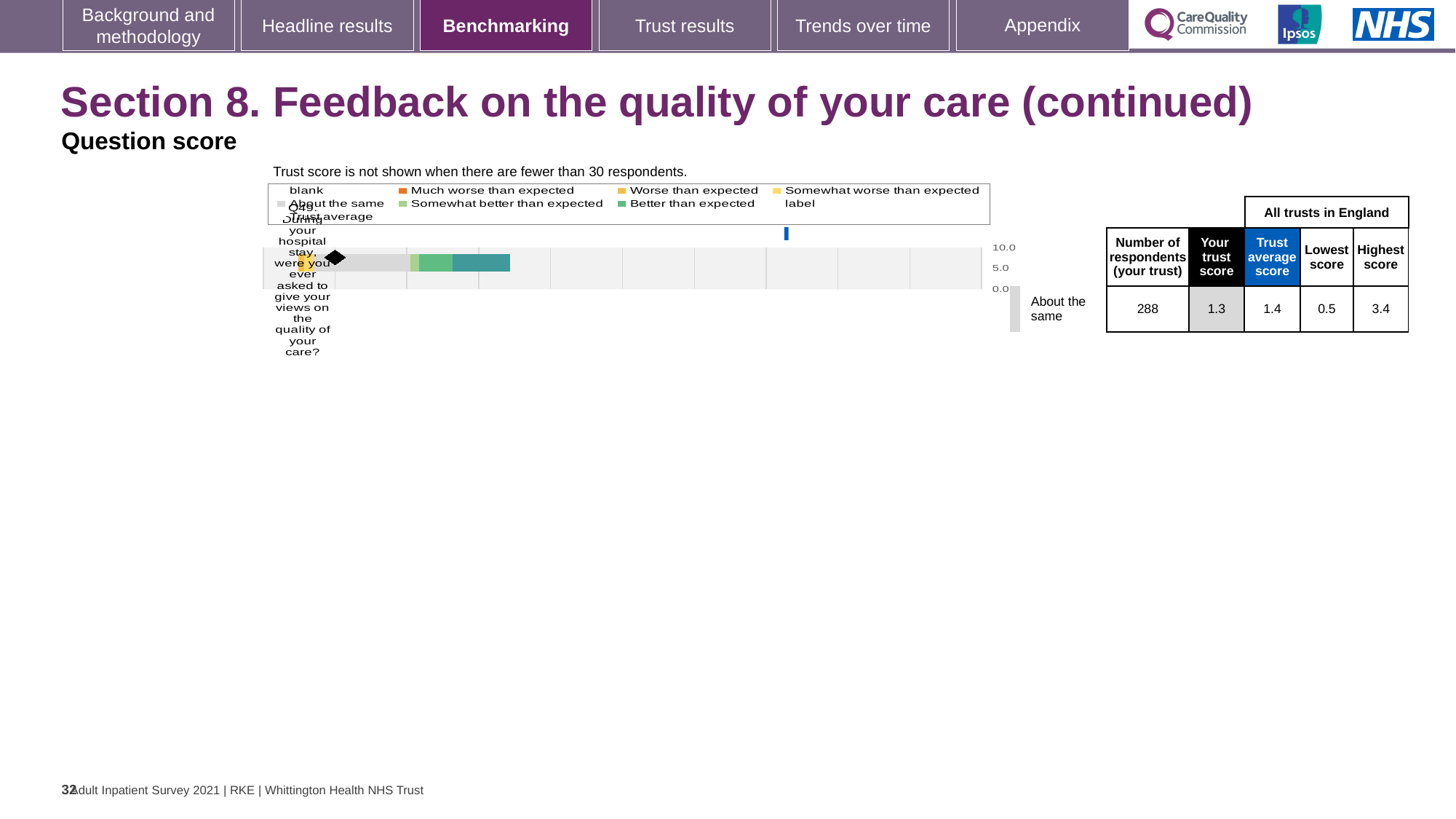
What kind of chart is used to show the benchmarking result for Q49? bar chart What is the highest score among all trusts in England for Q49? 3.4 How many survey questions are plotted in the benchmarking chart? 1 What benchmark category is shown for the trust on Q49? About the same What is the lowest score among all trusts in England for Q49? 0.5 How many respondents from the trust answered Q49? 288 Which question is plotted in the benchmarking chart? Q49. During your hospital stay, were you ever asked to give your views on the quality of your care? What is the trust's score for Q49? 1.3 What is the difference between the trust average score and the trust's score for Q49? 0.1 Which is larger for Q49: the trust's score or the trust average score? trust average score What is the trust average score for Q49 across all trusts in England? 1.4 What is the difference between the highest and lowest scores among all trusts in England for Q49? 2.9